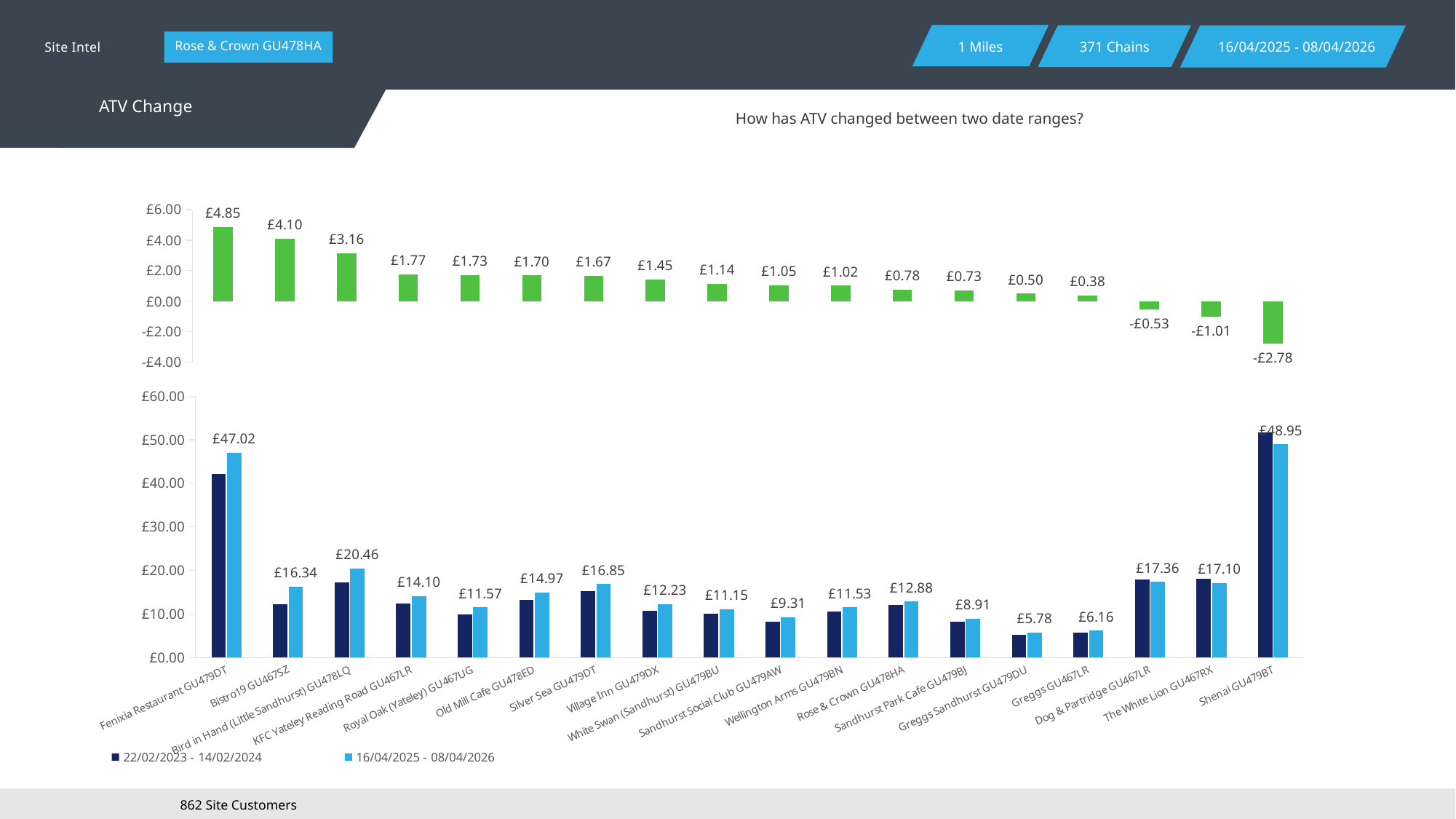
How many sites are shown on the x axis of the bottom chart? 18 In the bottom chart, what is the value for Shenai GU479BT in the 16/04/2025 - 08/04/2026 period? £48.95 How many series does the legend of the bottom chart list? 2 In the bottom chart, is the value for Fenixia Restaurant GU479DT in the 22/02/2023 - 14/02/2024 period greater or less than £40.00? greater In the top chart, what is the ATV change for Fenixia Restaurant GU479DT? £4.85 What kind of chart is the bottom chart? bar chart In the top chart, what is the difference between the ATV change for Fenixia Restaurant GU479DT and Bistro19 GU467SZ? £0.75 In the top chart, do the values rise or fall from left to right along the x axis? fall In the bottom chart, what is the value for Rose & Crown GU478HA in the 16/04/2025 - 08/04/2026 period? £12.88 In the top chart, which site has the lowest ATV change? Shenai GU479BT In the top chart, which site has the largest ATV change? Fenixia Restaurant GU479DT In the top chart, which has a larger ATV change: Bird in Hand (Little Sandhurst) GU478LQ or KFC Yateley Reading Road GU467LR? Bird in Hand (Little Sandhurst) GU478LQ